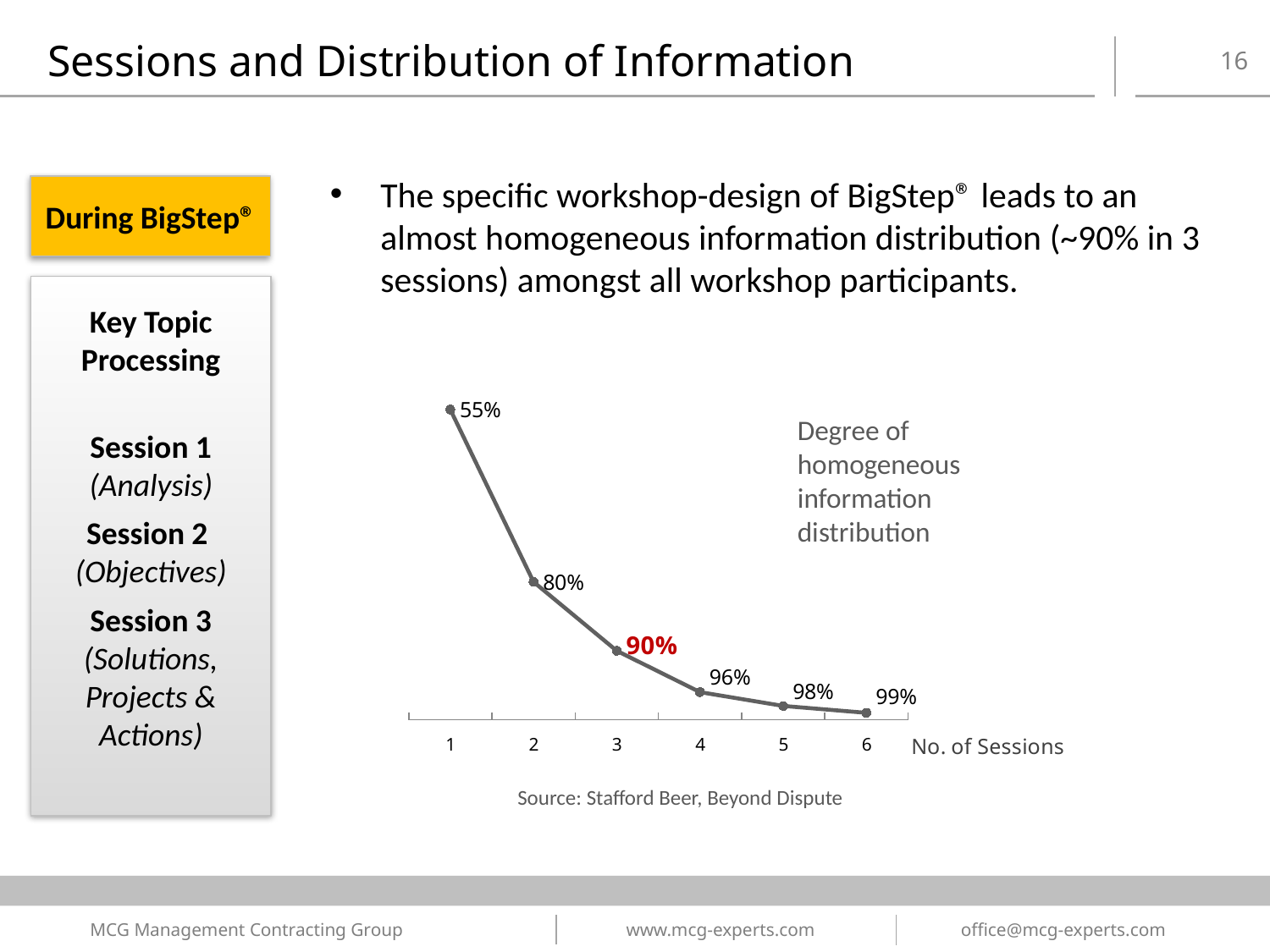
What is the difference between the values for 2 sessions and 1 session? 25% How many data points are plotted on the chart? 6 What is the degree of homogeneous information distribution after 1 session? 55% Which number of sessions has the lowest plotted value? 1 What is the degree of homogeneous information distribution after 3 sessions? 90% Which is larger, the value for 2 sessions or the value for 4 sessions? 4 sessions Do the plotted values rise or fall as the number of sessions increases? rise Which number of sessions has the highest plotted value? 6 What value is plotted for 6 sessions? 99% What type of chart is shown on the slide? line chart What is the difference between the values for 4 sessions and 3 sessions? 6% What value is plotted for 5 sessions? 98%